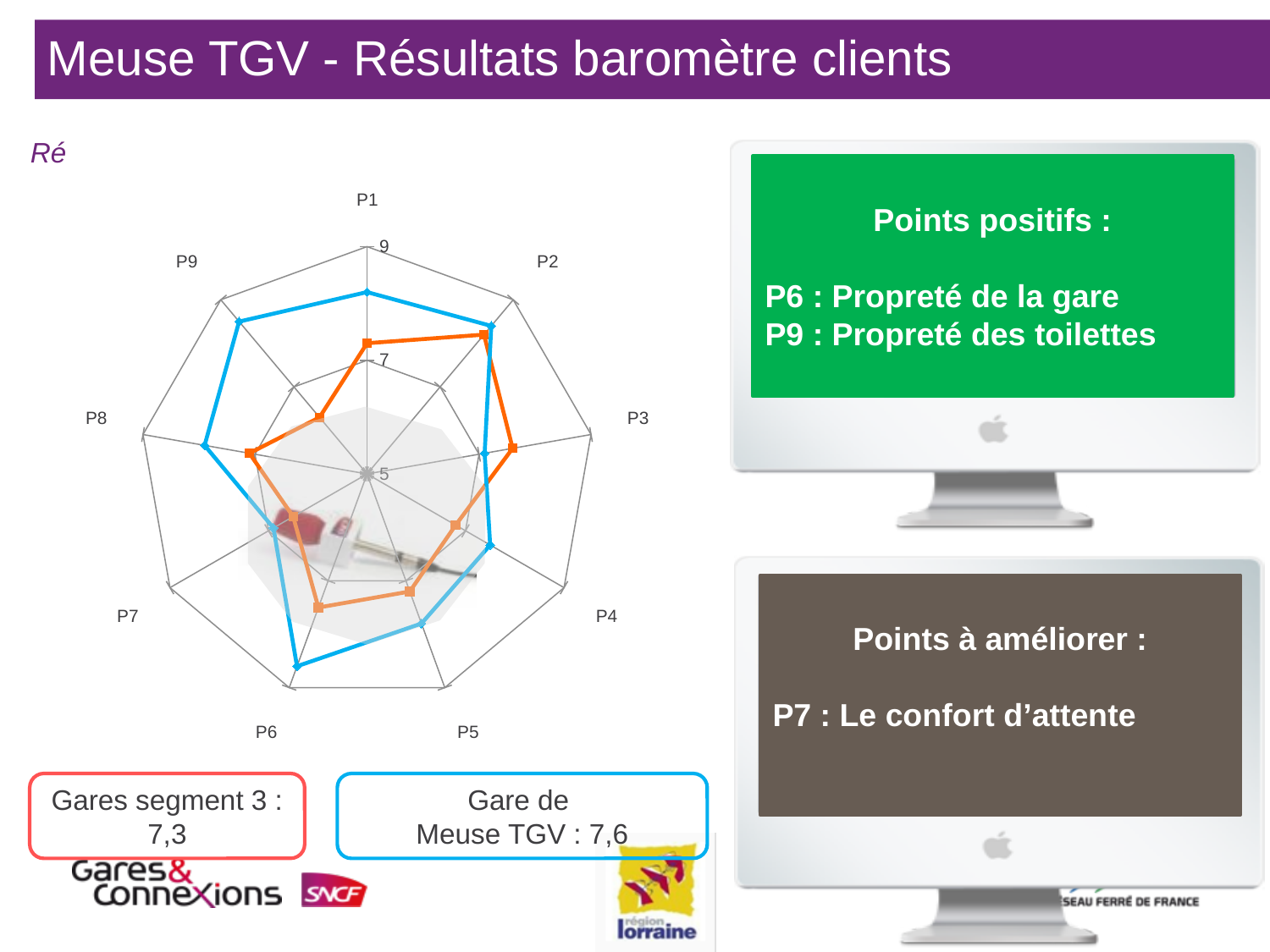
What overall score is shown for Gares segment 3 in the box below the chart? 7,3 What overall score is shown for Gare de Meuse TGV in the box below the chart? 7,6 How many series are plotted on the radar chart? 2 At P6, which series has the higher value, Gare de Meuse TGV (blue) or Gares segment 3 (orange)? Gare de Meuse TGV (blue) How many categories (P1 to P9) are plotted on the radar chart? 9 What kind of chart is shown on the slide? Radar chart For the orange Gares segment 3 series, which category has the highest value? P2 At P9, which series has the higher value, Gare de Meuse TGV (blue) or Gares segment 3 (orange)? Gare de Meuse TGV (blue) Is the orange (Gares segment 3) value for P7 greater or less than 7? less Is the blue (Gare de Meuse TGV) value for P6 greater or less than 7? greater Is the blue (Gare de Meuse TGV) value for P1 greater or less than 7? greater